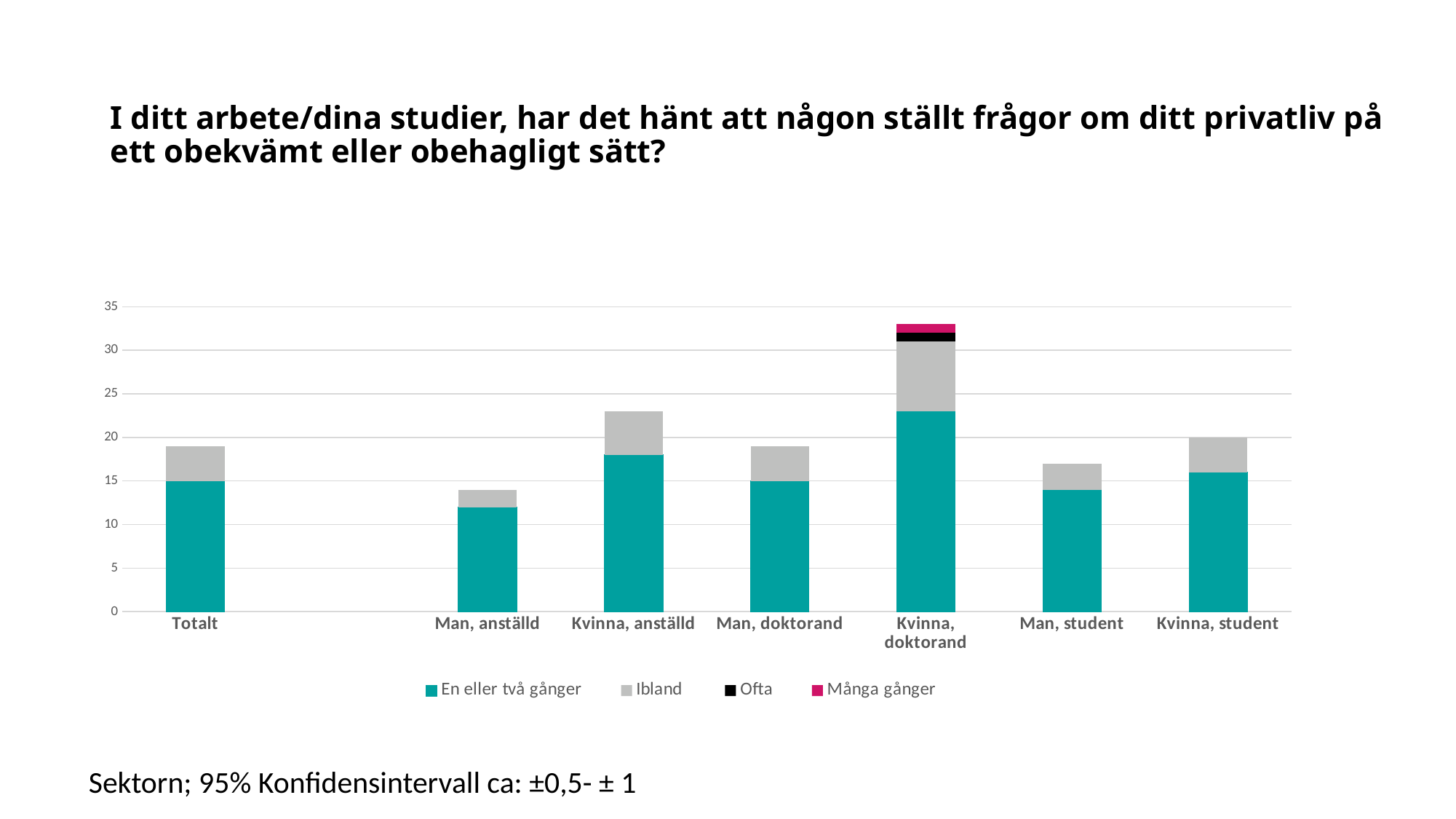
Is the total stacked value for Kvinna, doktorand greater or less than 30? greater Is the total stacked value for Man, anställd greater or less than 15? less Which category has the tallest stacked bar overall? Kvinna, doktorand How many series does the legend list? 4 What kind of chart is shown on the slide? Stacked bar chart Which has the taller stacked bar, Man, student or Kvinna, student? Kvinna, student Is the 'En eller två gånger' value for Kvinna, anställd greater or less than 15? greater Which has the taller stacked bar, Kvinna, anställd or Man, anställd? Kvinna, anställd How many categories are shown on the x axis of the chart? 7 What is the 'En eller två gånger' value for Totalt? 15 Which category has the shortest stacked bar overall? Man, anställd Which category is the only one with visible 'Ofta' and 'Många gånger' segments? Kvinna, doktorand